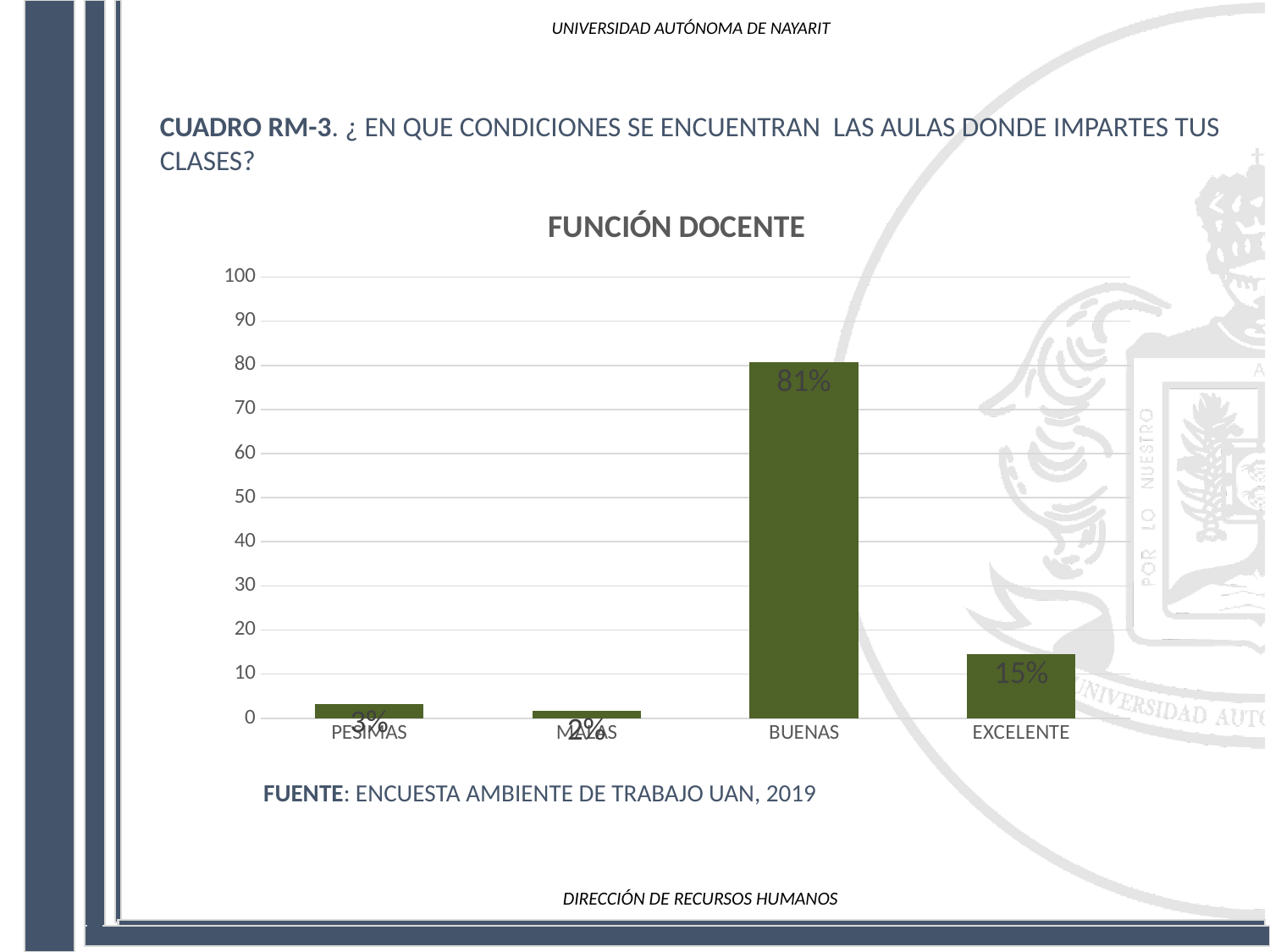
Which is larger, the value for EXCELENTE or the value for PESIMAS? EXCELENTE What is the value for EXCELENTE? 15% What kind of chart is shown? bar chart What is the value for BUENAS? 81% Is the value for EXCELENTE greater or less than 20? less What is the value for PESIMAS? 3% What is the title of the chart? FUNCIÓN DOCENTE How many categories are shown on the x axis? 4 What is the difference between the values for BUENAS and EXCELENTE? 66% Which category has the lowest value? MALAS Which category has the highest value? BUENAS Is the value for BUENAS greater or less than 70? greater